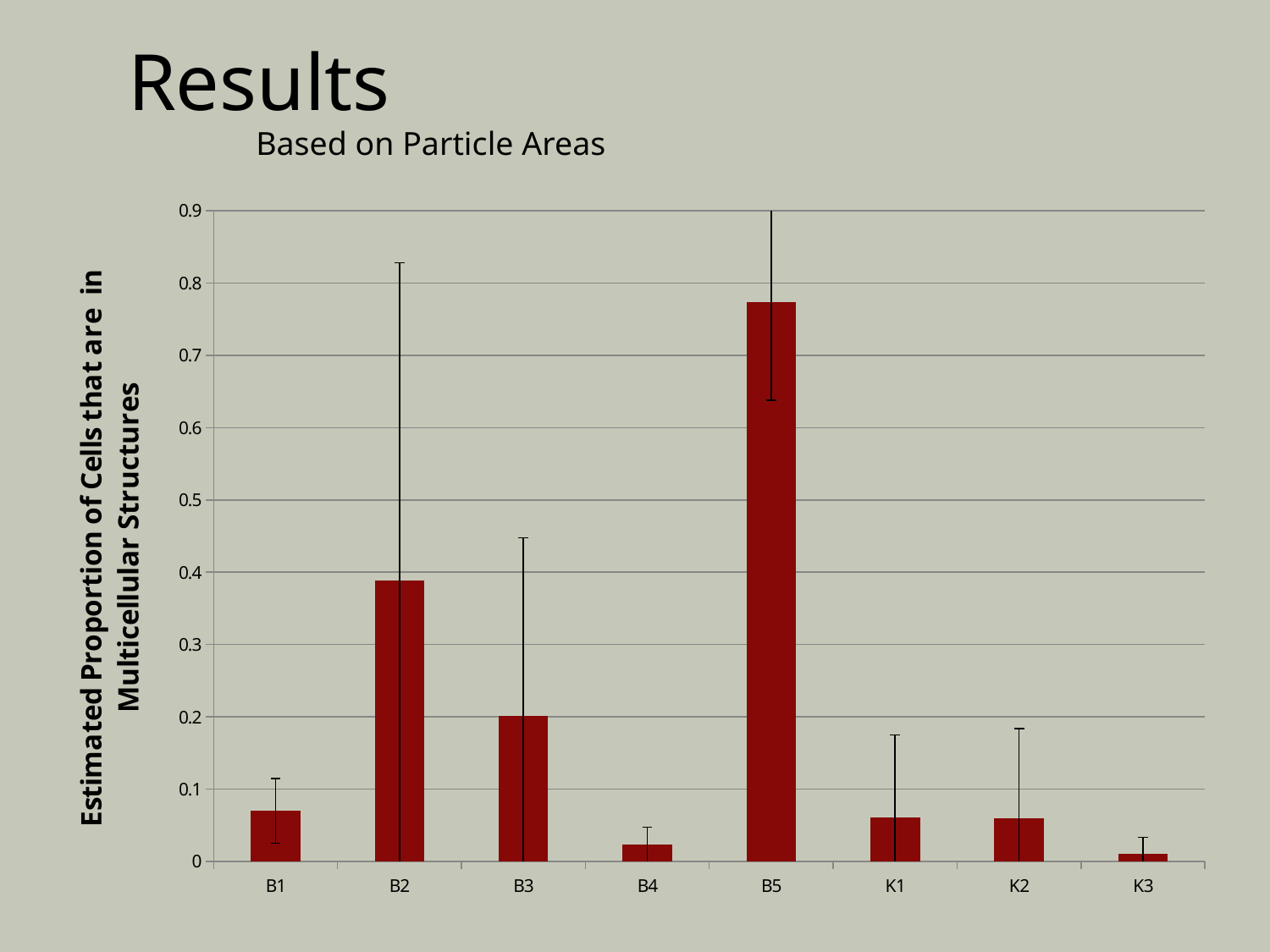
Which category has the highest estimated proportion of cells in multicellular structures? B5 Is the value for B3 greater or less than 0.1? greater Which has a larger value, B1 or B4? B1 What kind of chart is shown on the slide? bar chart What subtitle appears above the chart, below the word "Results"? Based on Particle Areas Is the value for K3 greater or less than 0.1? less Is the value for B5 greater or less than 0.7? greater Which has a larger value, B2 or B3? B2 What is the title of the y axis of the chart? Estimated Proportion of Cells that are in Multicellular Structures How many categories are shown on the x axis of the chart? 8